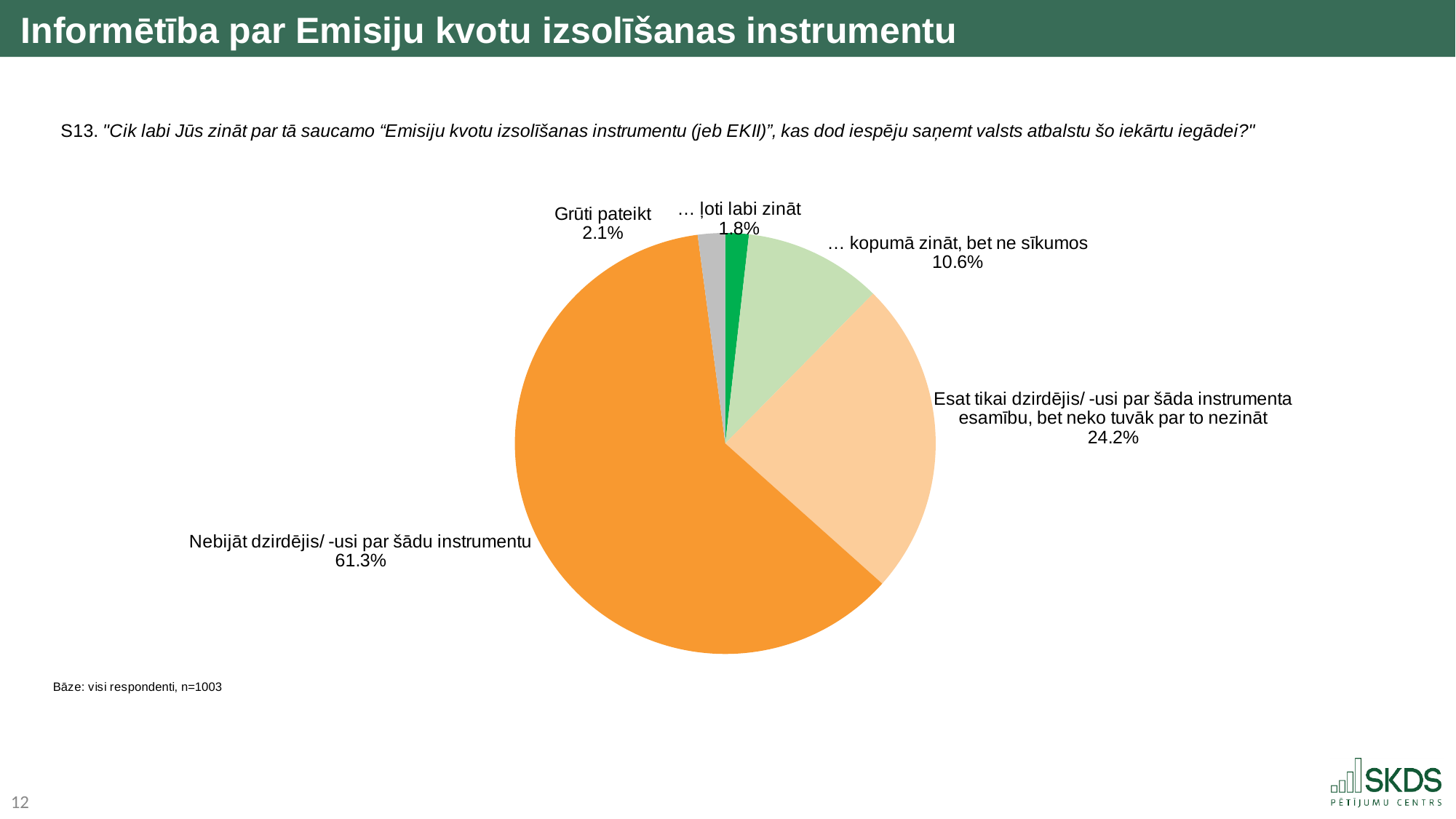
What share of respondents answered "… kopumā zināt, bet ne sīkumos"? 10.6% What share of respondents answered "Grūti pateikt"? 2.1% What is the base (number of respondents) stated below the chart? n=1003 What is the difference in percentage points between "Nebijāt dzirdējis/ -usi par šādu instrumentu" and "Esat tikai dzirdējis/ -usi par šāda instrumenta esamību, bet neko tuvāk par to nezināt"? 37.1 percentage points What share of respondents answered "Nebijāt dzirdējis/ -usi par šādu instrumentu"? 61.3% Which answer category has the largest share of the pie? Nebijāt dzirdējis/ -usi par šādu instrumentu How many slices does the pie chart have? 5 Which answer category has the smallest share of the pie? … ļoti labi zināt What share of respondents answered "Esat tikai dzirdējis/ -usi par šāda instrumenta esamību, bet neko tuvāk par to nezināt"? 24.2% Which is larger: the share for "Grūti pateikt" or the share for "… ļoti labi zināt"? Grūti pateikt What share of respondents answered "… ļoti labi zināt"? 1.8% What kind of chart is shown on the slide? pie chart